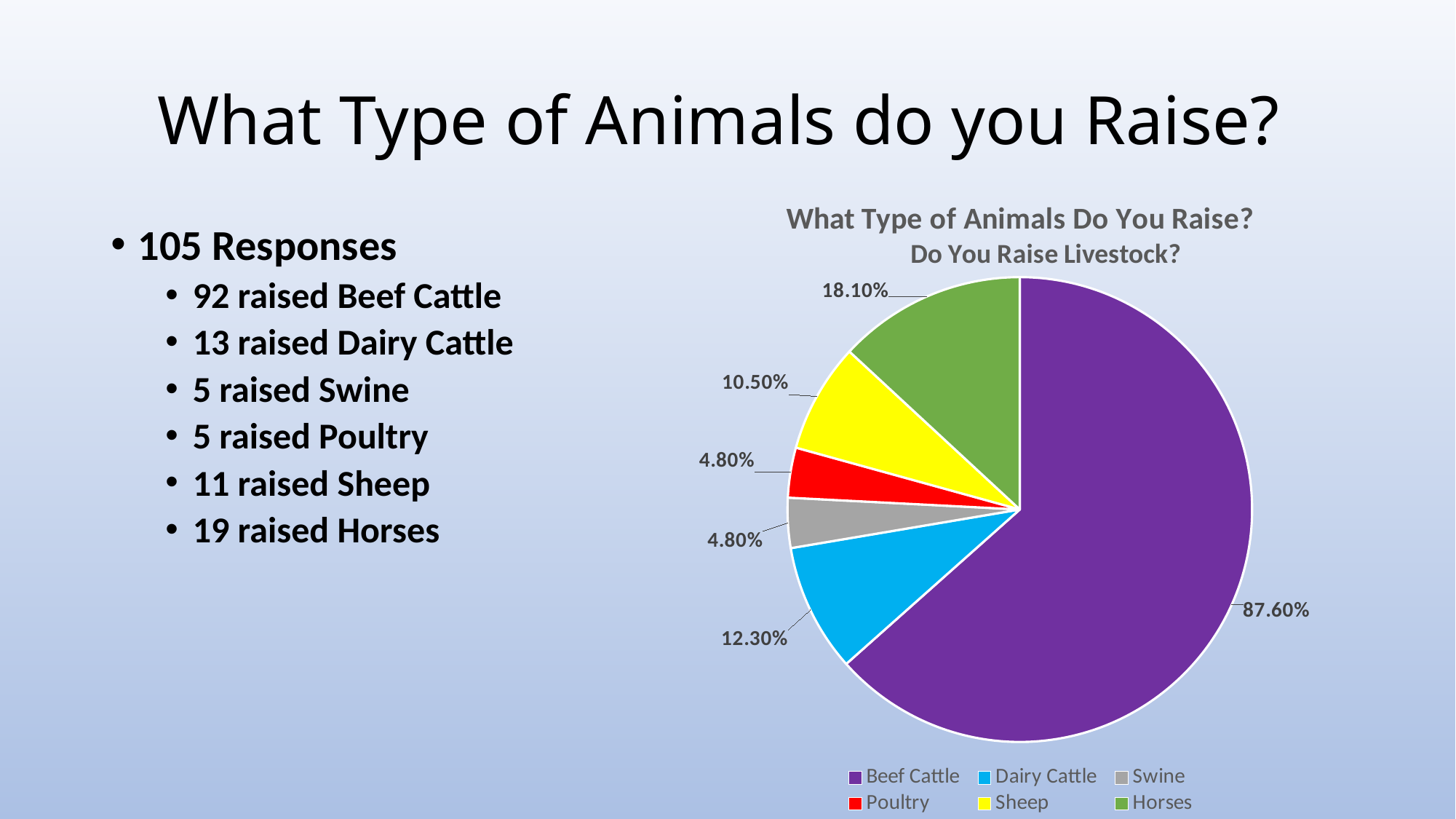
What percentage is shown for Sheep in the pie chart? 10.50% What is the title of the pie chart? What Type of Animals Do You Raise? Do You Raise Livestock? Which category has a larger slice, Horses or Dairy Cattle? Horses What percentage is shown for Swine in the pie chart? 4.80% What colour is the Sheep slice in the pie chart? yellow What percentage is shown for Beef Cattle in the pie chart? 87.60% What type of chart is shown on the slide? pie chart How many categories does the legend of the pie chart list? 6 What is the difference between the percentages shown for Horses and Sheep? 7.60% Which category has the largest slice in the pie chart? Beef Cattle What percentage is shown for Dairy Cattle in the pie chart? 12.30% What percentage is shown for Horses in the pie chart? 18.10%